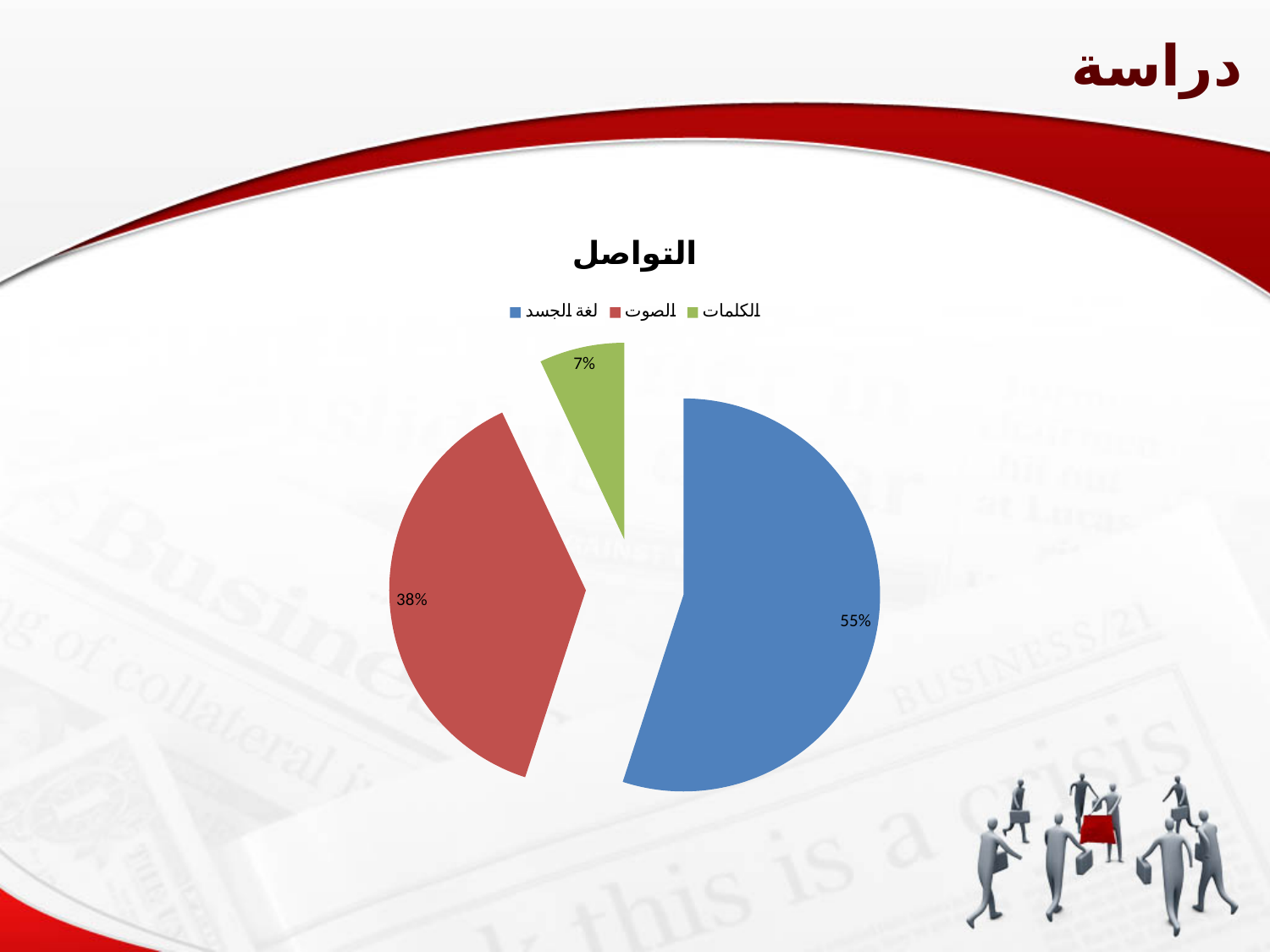
Which category has the largest slice of the pie? لغة الجسد What share of the pie does الكلمات have? 7% What share of the pie does لغة الجسد have? 55% What is the title of the chart? التواصل What kind of chart is shown on the slide? pie chart What percentage is shown on the red slice? 38% What is the difference between the blue slice (55%) and the red slice (38%)? 17% What percentage is shown on the blue slice? 55% How many slices does the pie chart have? 3 What percentage is shown on the green slice? 7% How many entries does the legend list? 3 Which category has the smallest slice of the pie? الكلمات